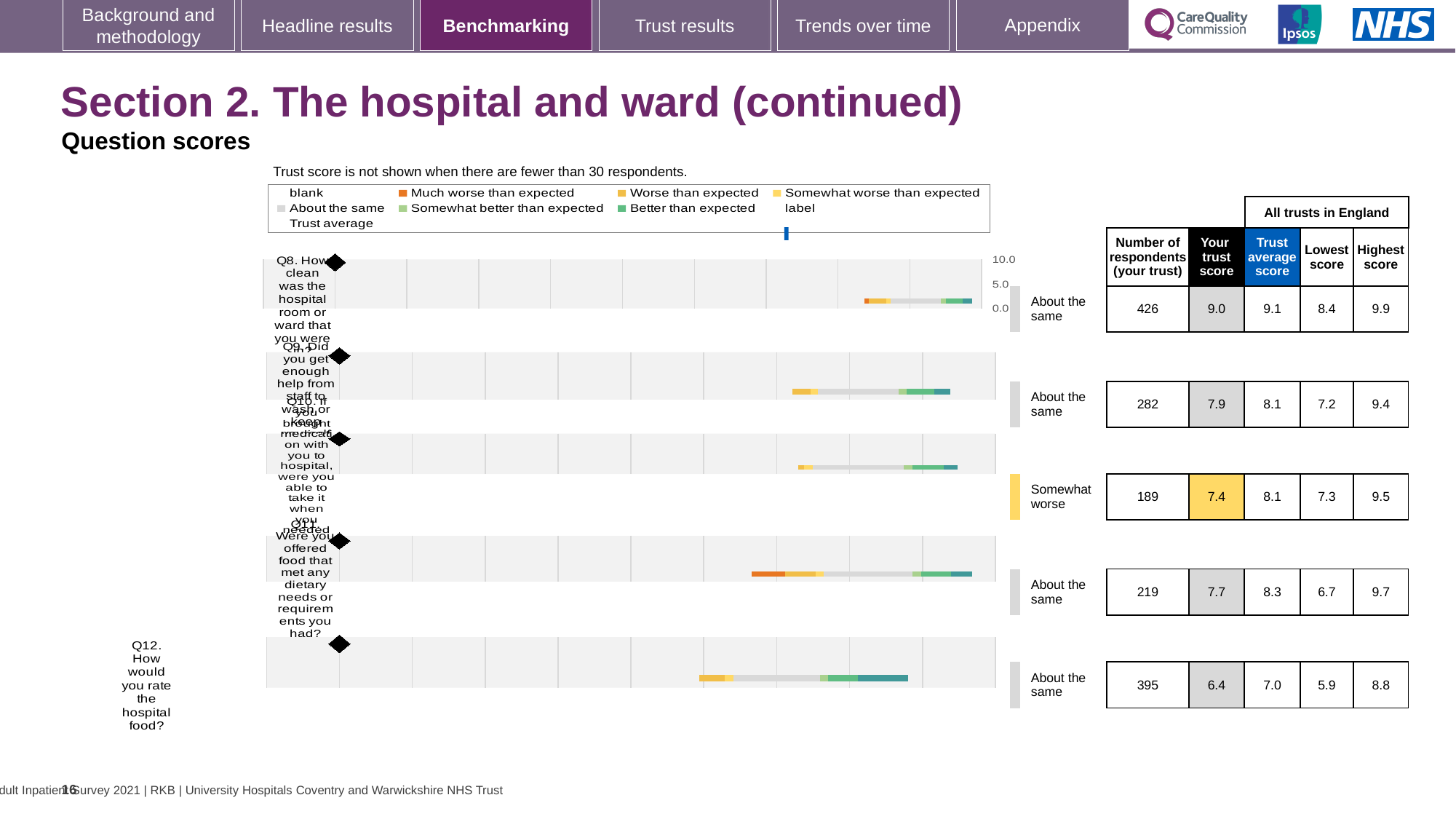
What kind of chart is used to show the question scores on this slide? bar chart Which question has the lowest 'Your trust score'? Q12 How many questions (categories) are plotted in the question scores chart? 5 What is the 'Your trust score' for Q12 (How would you rate the hospital food)? 6.4 What is the difference between the 'Your trust score' for Q8 and for Q12? 2.6 Which question has the highest 'Your trust score'? Q8 Which question is rated 'Somewhat worse' than expected? Q10 Which has the larger 'Your trust score', Q9 or Q11? Q9 What is the 'Your trust score' for Q8 (How clean was the hospital room or ward)? 9.0 What is the highest score across all trusts in England for Q9? 9.4 What is the trust average score for Q11 (Were you offered food that met any dietary needs)? 8.3 How many respondents from your trust answered Q10? 189